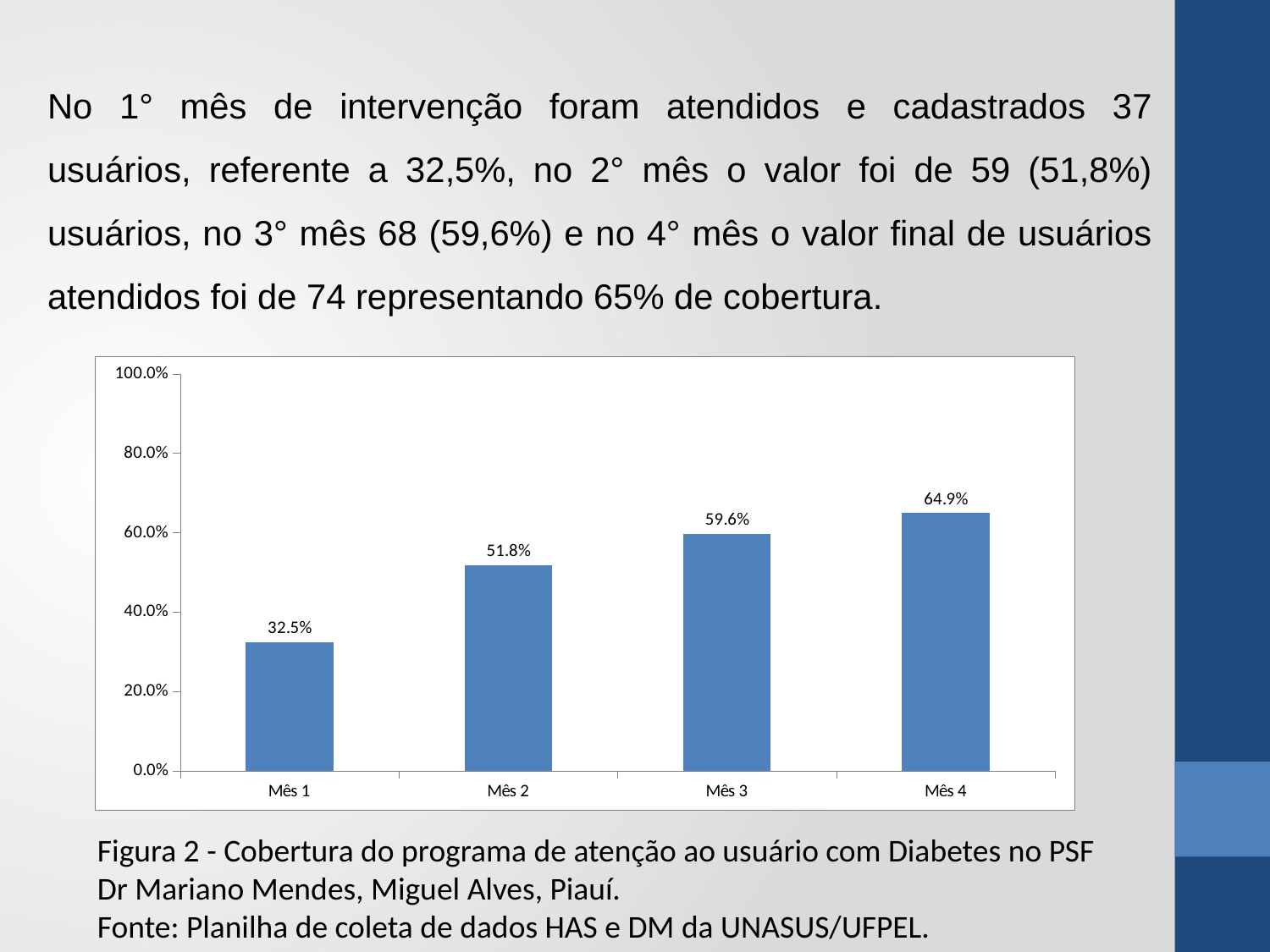
What is the difference between the values for Mês 4 and Mês 1? 32.4% Which month has the highest value? Mês 4 What is the value for Mês 1? 32.5% Which month has the lowest value? Mês 1 What is the value for Mês 3? 59.6% What is the value for Mês 2? 51.8% What is the difference between the values for Mês 2 and Mês 1? 19.3% How many bars are shown in the chart? 4 Which is larger, the value for Mês 2 or the value for Mês 3? Mês 3 What is the value for Mês 4? 64.9% Is the value for Mês 4 greater or less than 60.0%? greater Do the values rise or fall from Mês 1 to Mês 4? rise